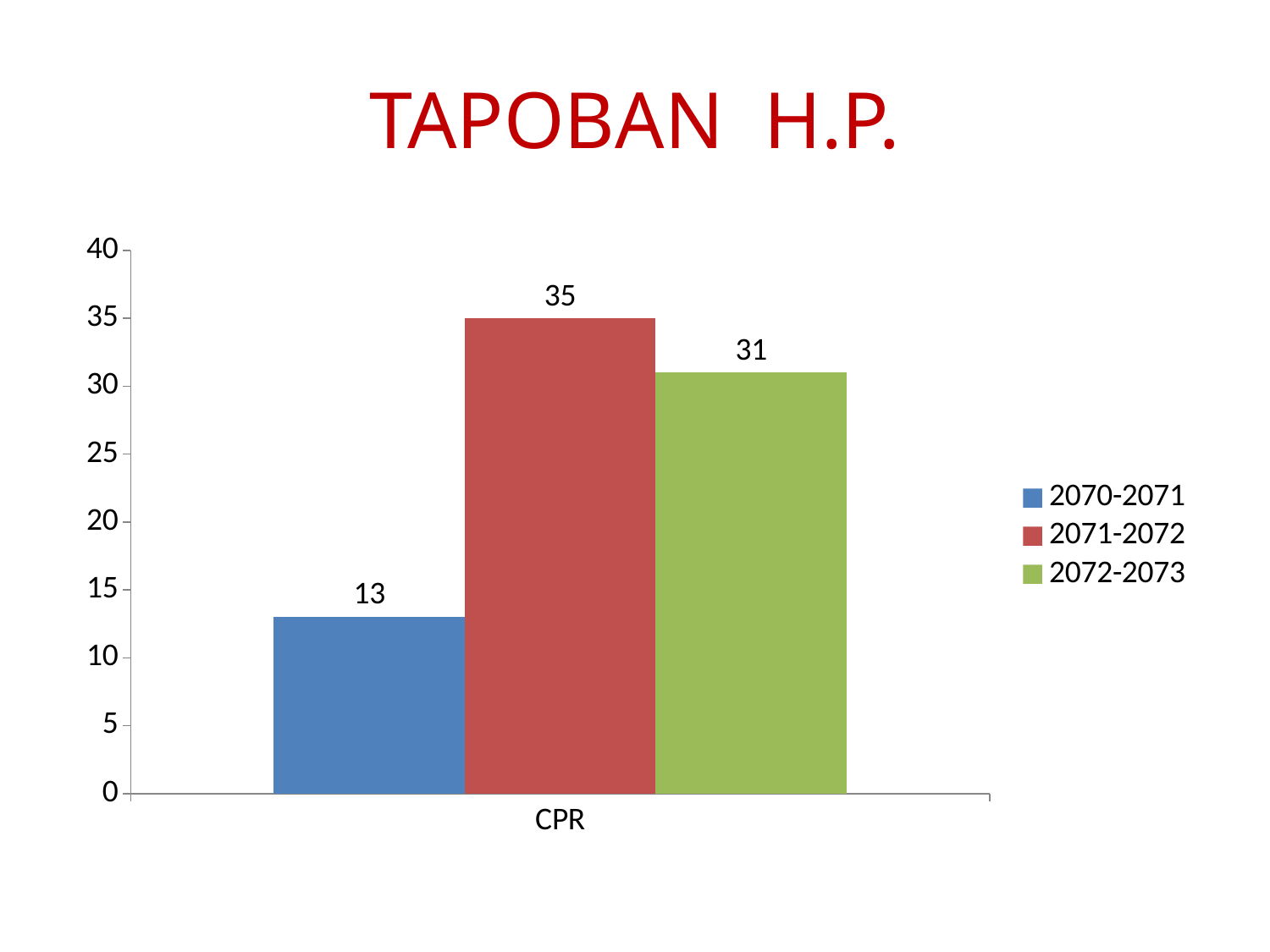
What is the CPR value for 2070-2071? 13 How many series does the legend list? 3 Which year range has the highest CPR value? 2071-2072 Which is larger, the CPR value for 2072-2073 or for 2070-2071? 2072-2073 What is the difference between the CPR values for 2071-2072 and 2070-2071? 22 What is the title of the slide? TAPOBAN H.P. What kind of chart is shown on the slide? bar chart What is the CPR value for 2071-2072? 35 What is the difference between the CPR values for 2071-2072 and 2072-2073? 4 What is the CPR value for 2072-2073? 31 Is the CPR value for 2071-2072 greater or less than 30? greater Which year range has the lowest CPR value? 2070-2071